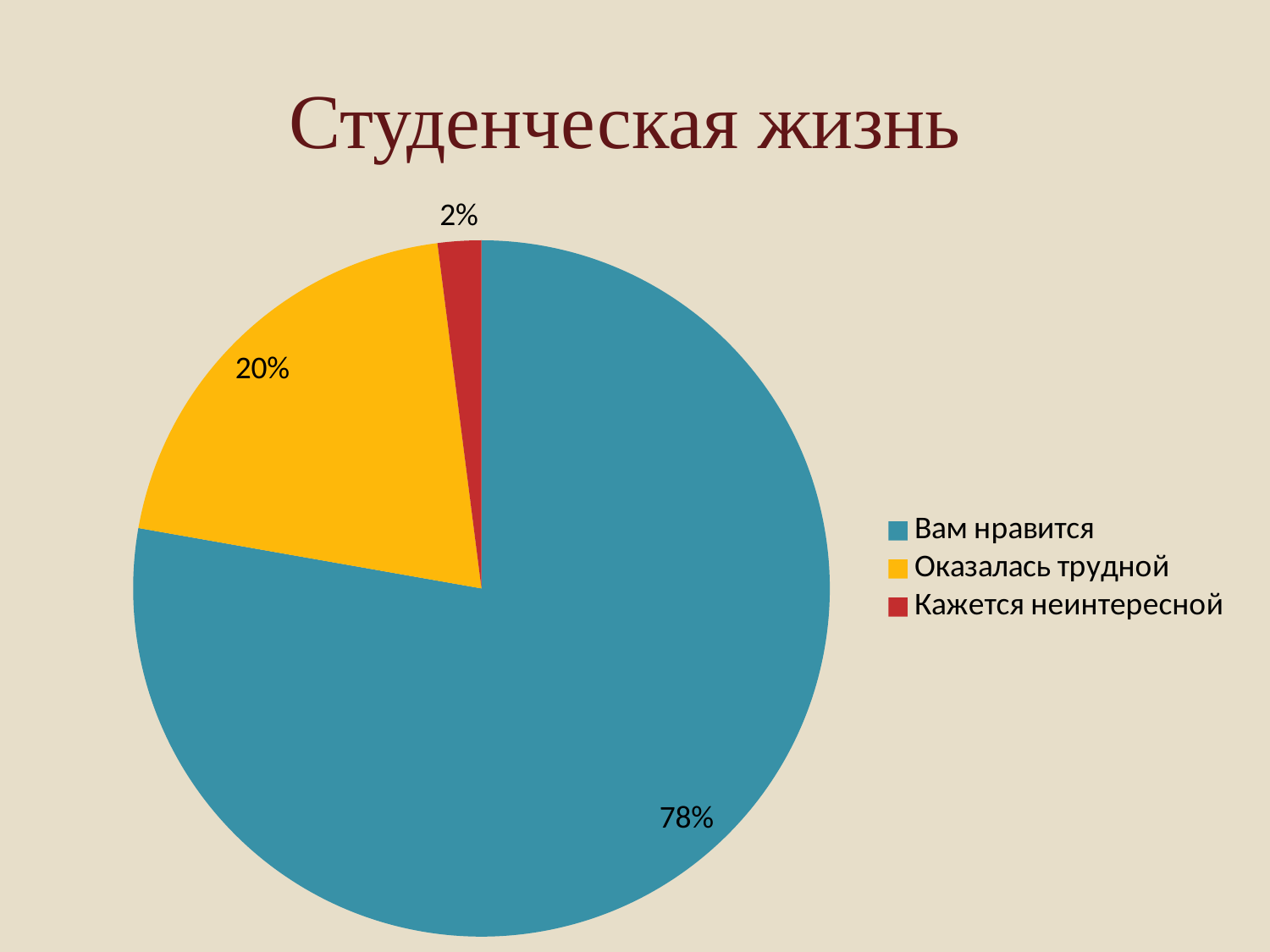
What is the difference in percentage points between "Вам нравится" and "Оказалась трудной"? 58 How many slices does the pie chart have? 3 What is the title of the slide? Студенческая жизнь What is the difference in percentage points between "Оказалась трудной" and "Кажется неинтересной"? 18 Which is larger: the slice for "Оказалась трудной" or the slice for "Кажется неинтересной"? Оказалась трудной What kind of chart is shown on the slide? Pie chart Which colour represents "Оказалась трудной" in the legend? Yellow Which category has the largest slice of the pie? Вам нравится What share of the pie does "Кажется неинтересной" take? 2% Which category has the smallest slice of the pie? Кажется неинтересной What share of the pie does "Оказалась трудной" take? 20% What share of the pie does "Вам нравится" take? 78%